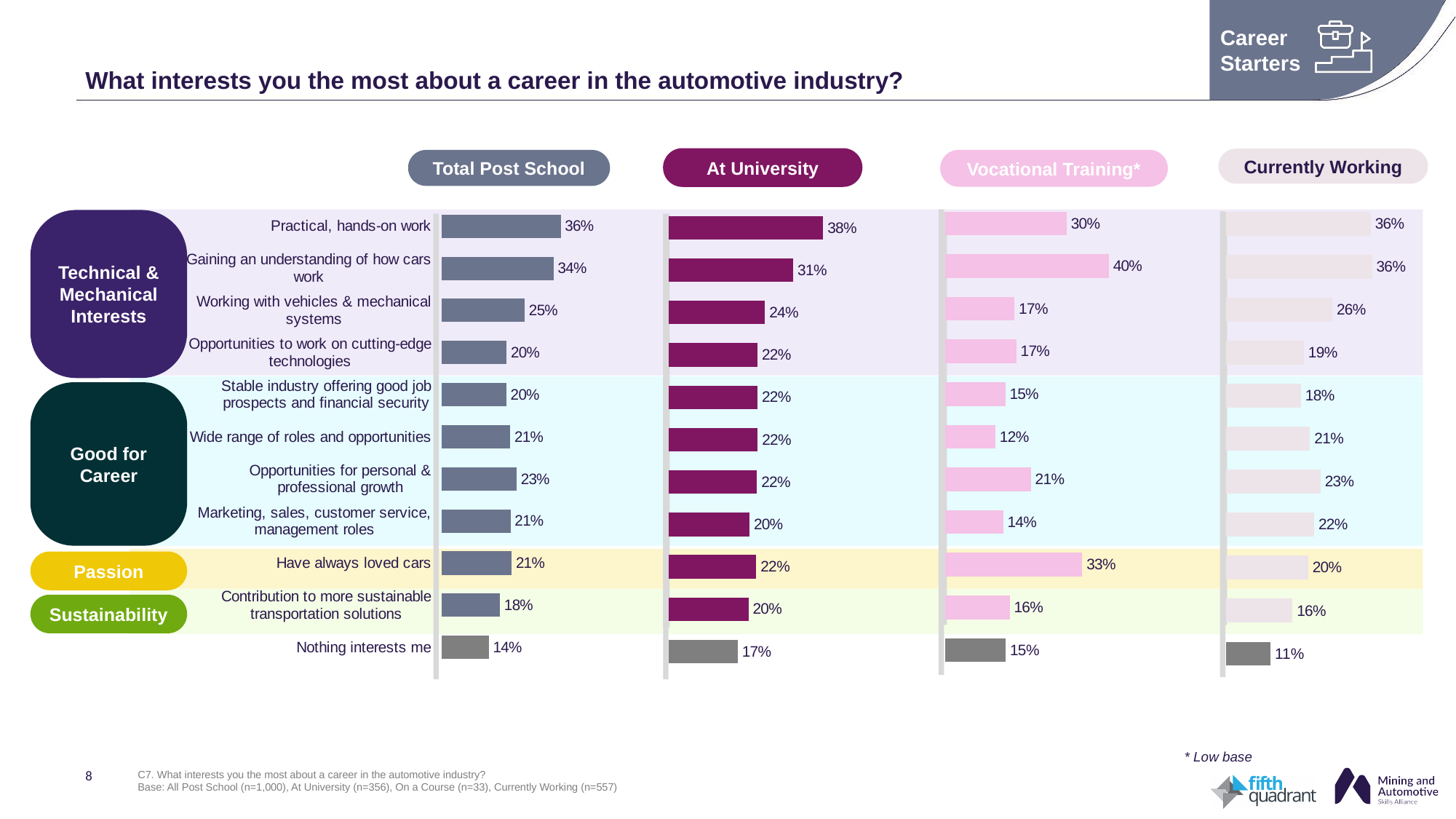
Which of the four charts is marked with an asterisk indicating a low base? Vocational Training* In the Vocational Training* chart, which is larger: 'Wide range of roles and opportunities' or 'Opportunities for personal & professional growth'? Opportunities for personal & professional growth In the Total Post School chart, what percentage is shown for 'Practical, hands-on work'? 36% In the Vocational Training* chart, what percentage is shown for 'Have always loved cars'? 33% In the At University chart, what percentage is shown for 'Gaining an understanding of how cars work'? 31% In the Vocational Training* chart, which category has the highest value? Gaining an understanding of how cars work In the Total Post School chart, what is the difference between 'Practical, hands-on work' and 'Contribution to more sustainable transportation solutions'? 18 percentage points In the Currently Working chart, what percentage is shown for 'Nothing interests me'? 11% In the Currently Working chart, what is the difference between 'Working with vehicles & mechanical systems' and 'Opportunities to work on cutting-edge technologies'? 7 percentage points What type of chart is used for the At University data? Bar chart In the At University chart, which category has the lowest value? Nothing interests me How many categories are plotted in the Total Post School chart? 11